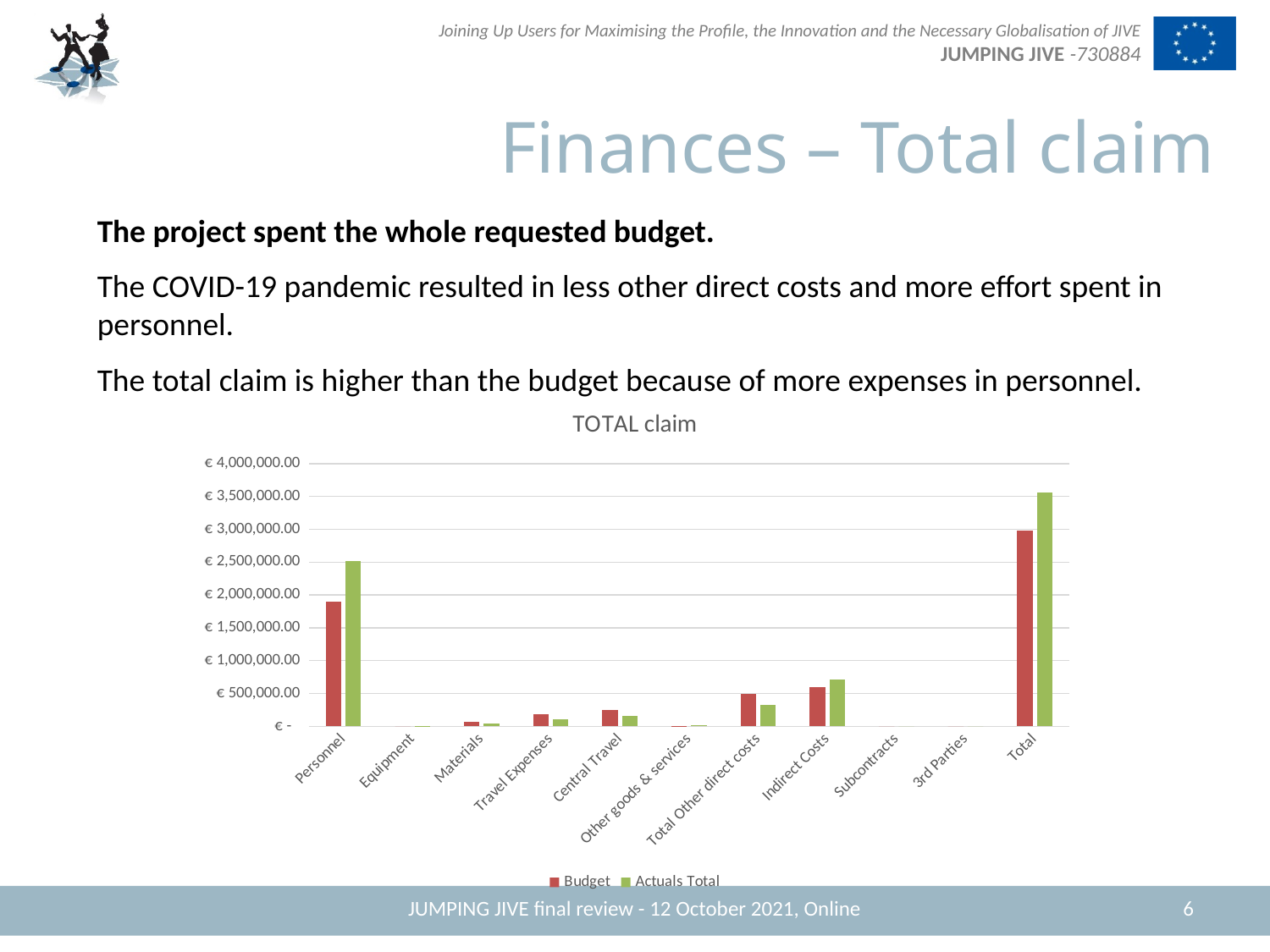
Which category has the highest Actuals Total bar? Total Is the Actuals Total value for Total greater or less than € 3,000,000.00? greater What kind of chart is shown on the slide? bar chart What is the title of the chart? TOTAL claim For Personnel, which is larger: Budget or Actuals Total? Actuals Total For Total Other direct costs, which is larger: Budget or Actuals Total? Budget How many series does the chart's legend list? 2 Which category has the highest Budget bar? Total How many categories are shown along the x axis of the chart? 11 What are the two series named in the legend? Budget and Actuals Total For Indirect Costs, which is larger: Budget or Actuals Total? Actuals Total Is the Budget value for Personnel greater or less than € 2,000,000.00? less